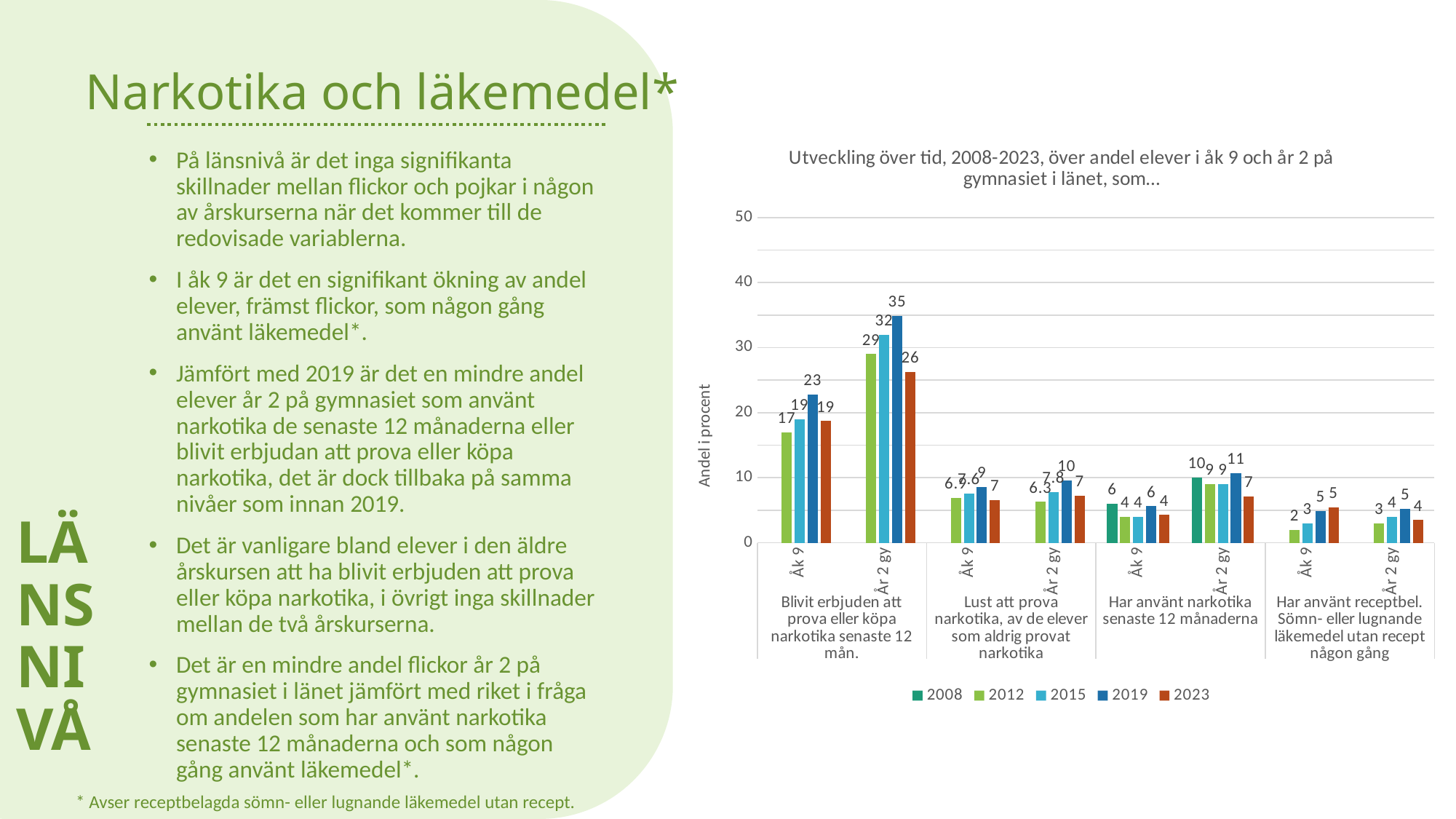
In the group 'Blivit erbjuden att prova eller köpa narkotika senaste 12 mån.', what is the 2023 value for Åk 9? 19 What kind of chart is shown on the slide? Bar chart In the group 'Har använt receptbel. Sömn- eller lugnande läkemedel utan recept någon gång', what is the 2012 value for Åk 9? 2 In the group 'Har använt narkotika senaste 12 månaderna', what is the 2023 value for År 2 gy? 7 In the group 'Har använt narkotika senaste 12 månaderna', what is the 2019 value for År 2 gy? 11 In the group 'Blivit erbjuden att prova eller köpa narkotika senaste 12 mån.', what is the 2019 value for År 2 gy? 35 For År 2 gy in the group 'Blivit erbjuden att prova eller köpa narkotika senaste 12 mån.', which year has the highest value? 2019 For År 2 gy in the group 'Blivit erbjuden att prova eller köpa narkotika senaste 12 mån.', which year has the lowest value? 2023 Is the 2012 value for År 2 gy in the group 'Blivit erbjuden att prova eller köpa narkotika senaste 12 mån.' greater or less than 20? greater For Åk 9 in the group 'Blivit erbjuden att prova eller köpa narkotika senaste 12 mån.', which is larger: the 2019 value or the 2023 value? 2019 How many series does the legend list? 5 For År 2 gy in the group 'Blivit erbjuden att prova eller köpa narkotika senaste 12 mån.', what is the difference between the 2019 and 2023 values? 9